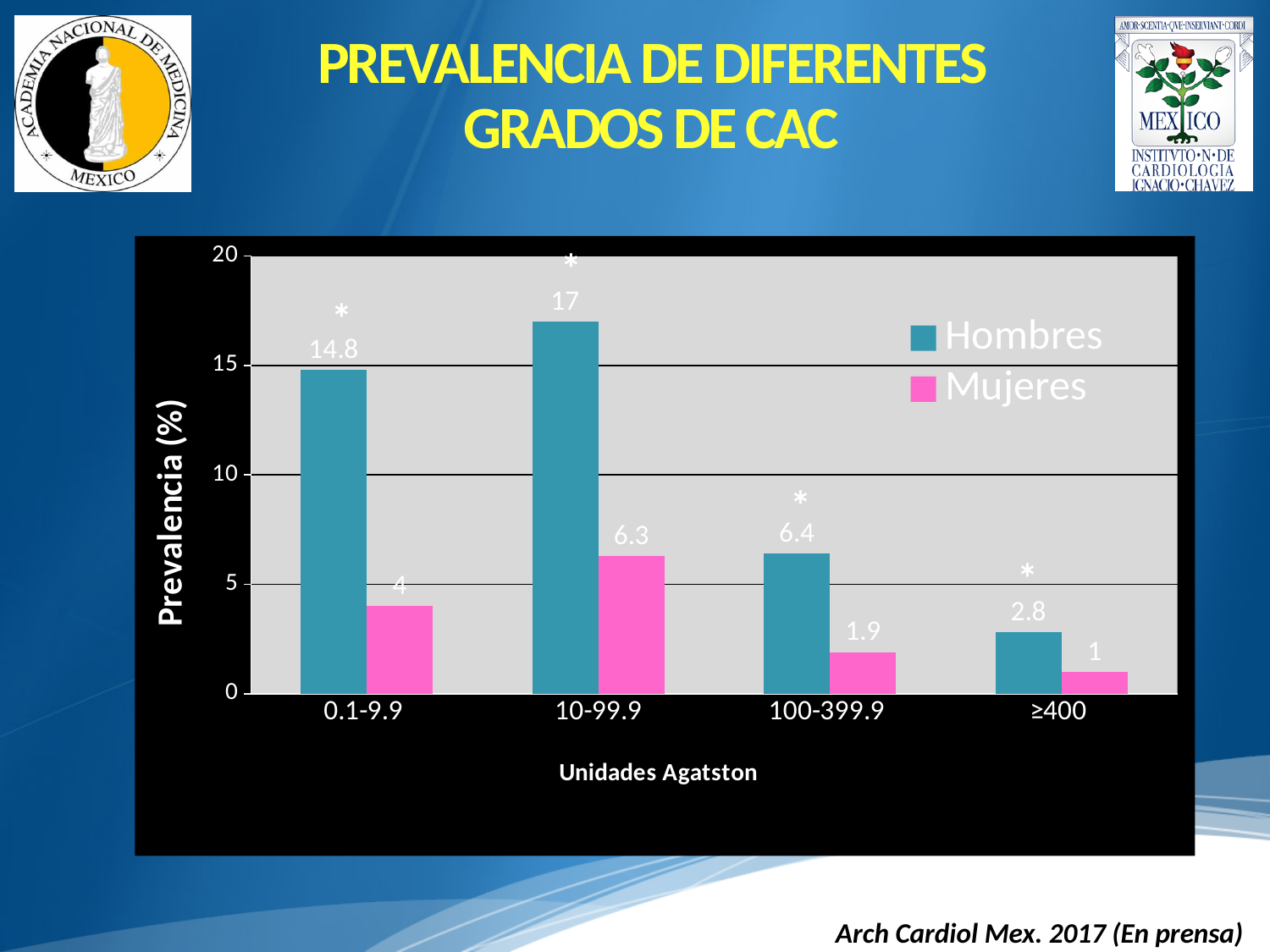
What is the value for Mujeres in the 0.1-9.9 category? 4 What is the label of the y axis? Prevalencia (%) Which category has the highest value for Hombres? 10-99.9 Which is larger in the 0.1-9.9 category, Hombres or Mujeres? Hombres What is the value for Hombres in the 10-99.9 category? 17 What is the value for Mujeres in the ≥400 category? 1 Which category has the lowest value for Mujeres? ≥400 What is the label of the x axis? Unidades Agatston What kind of chart is shown on the slide? Bar chart What is the difference between Hombres and Mujeres in the 100-399.9 category? 4.5 How many series does the legend list? 2 How many categories are shown on the x axis? 4